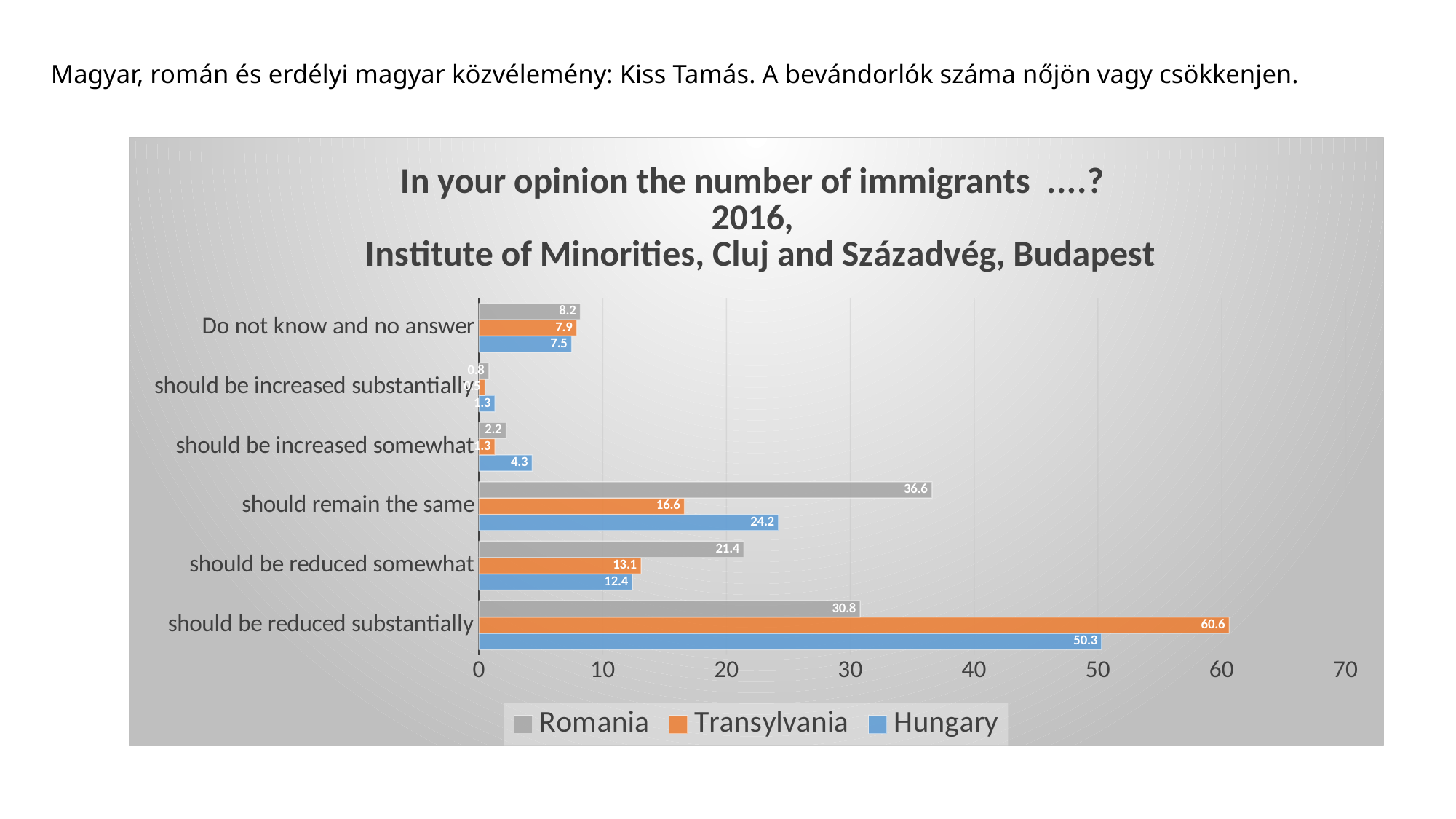
Is the Romania value for "should be reduced substantially" greater or less than 40? less Which category has the lowest value for the Romania series? should be increased substantially What kind of chart is shown on the slide? bar chart What is the difference between the Transylvania and Hungary values for "should be reduced substantially"? 10.3 Which category has the highest value for the Hungary series? should be reduced substantially For "should remain the same", which is larger: the Romania value or the Hungary value? Romania What is the Romania value for "should remain the same"? 36.6 How many response categories are shown on the chart? 6 What is the Hungary value for "should be reduced somewhat"? 12.4 How many series does the legend list? 3 What is the Transylvania value for "should be reduced substantially"? 60.6 What is the Hungary value for "Do not know and no answer"? 7.5